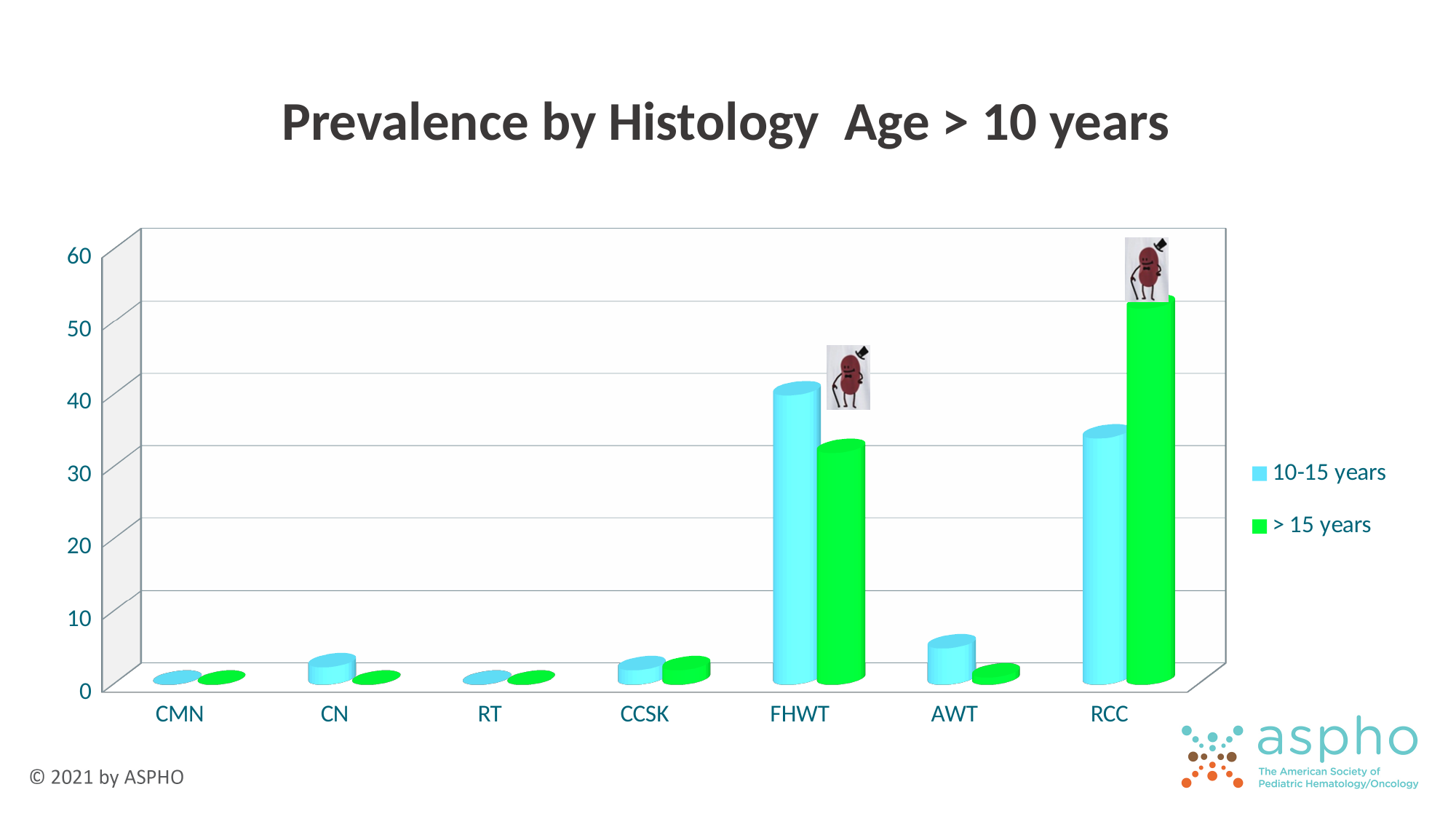
Which histology has the highest value for the > 15 years series? RCC How many series does the legend list? 2 Is the value for AWT in the 10-15 years series greater or less than 10? less What is the title of the chart? Prevalence by Histology Age > 10 years Which series is shown in green in the legend? > 15 years What kind of chart is shown on the slide? bar chart For FHWT, which series has the larger value, 10-15 years or > 15 years? 10-15 years Which histology has the highest value for the 10-15 years series? FHWT For RCC, which series has the larger value, 10-15 years or > 15 years? > 15 years Is the value for RCC in the > 15 years series greater or less than 40? greater How many histology categories are shown on the x axis? 7 Is the value for FHWT in the 10-15 years series greater or less than 30? greater